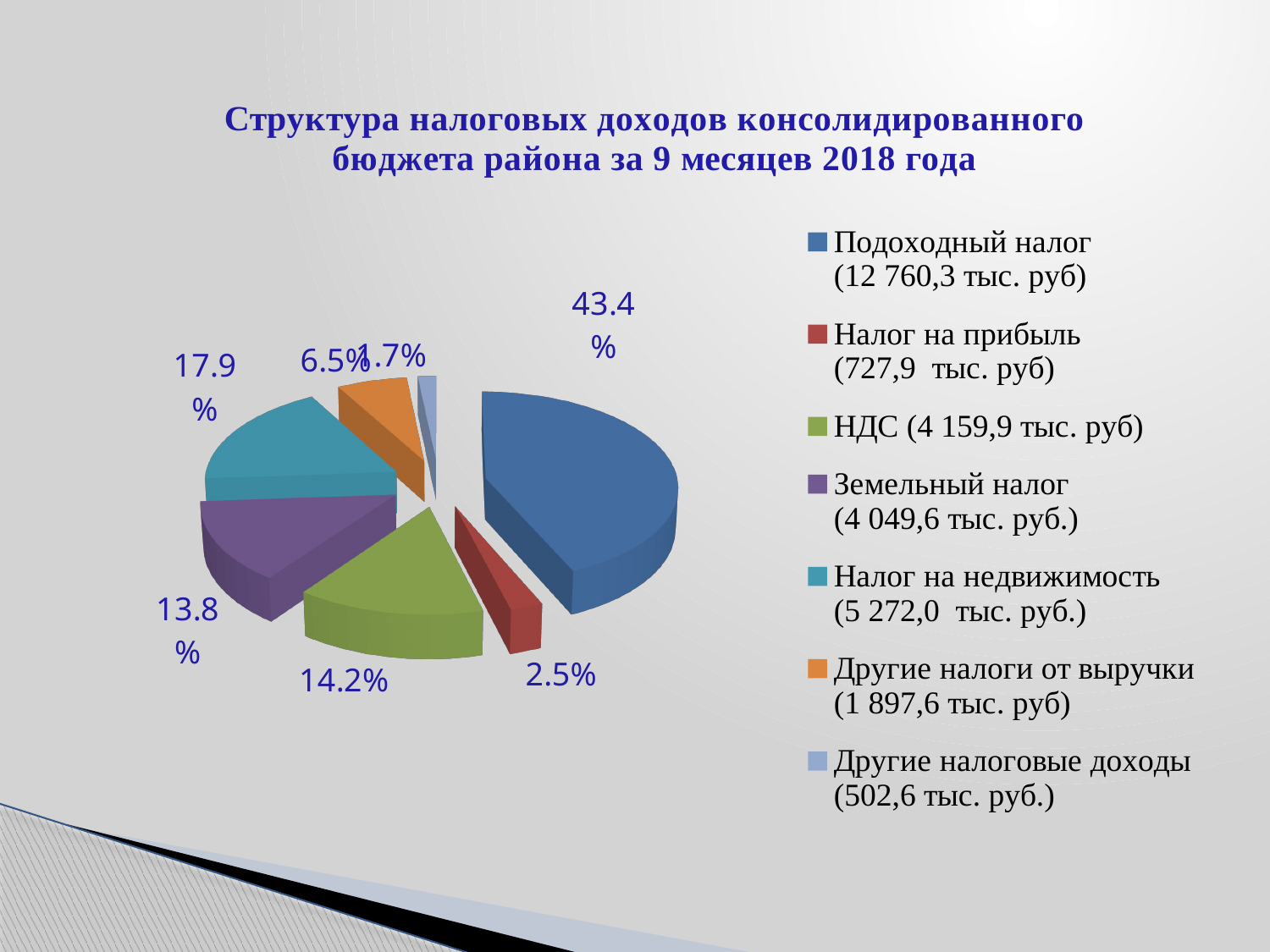
What share of the pie does Земельный налог have? 13.8% What amount in thousand rubles does the legend give for Земельный налог? 4 049,6 тыс. руб. How many slices does the pie chart have? 7 What is the difference in percentage points between the shares of Налог на недвижимость and НДС? 3.7 What share of the pie does НДС have? 14.2% Which category has the smallest share of the pie? Другие налоговые доходы Which has a larger share, Другие налоги от выручки or Налог на прибыль? Другие налоги от выручки What share of the pie does Налог на прибыль have? 2.5% Which category has the largest share of the pie? Подоходный налог What kind of chart is shown on the slide? Pie chart